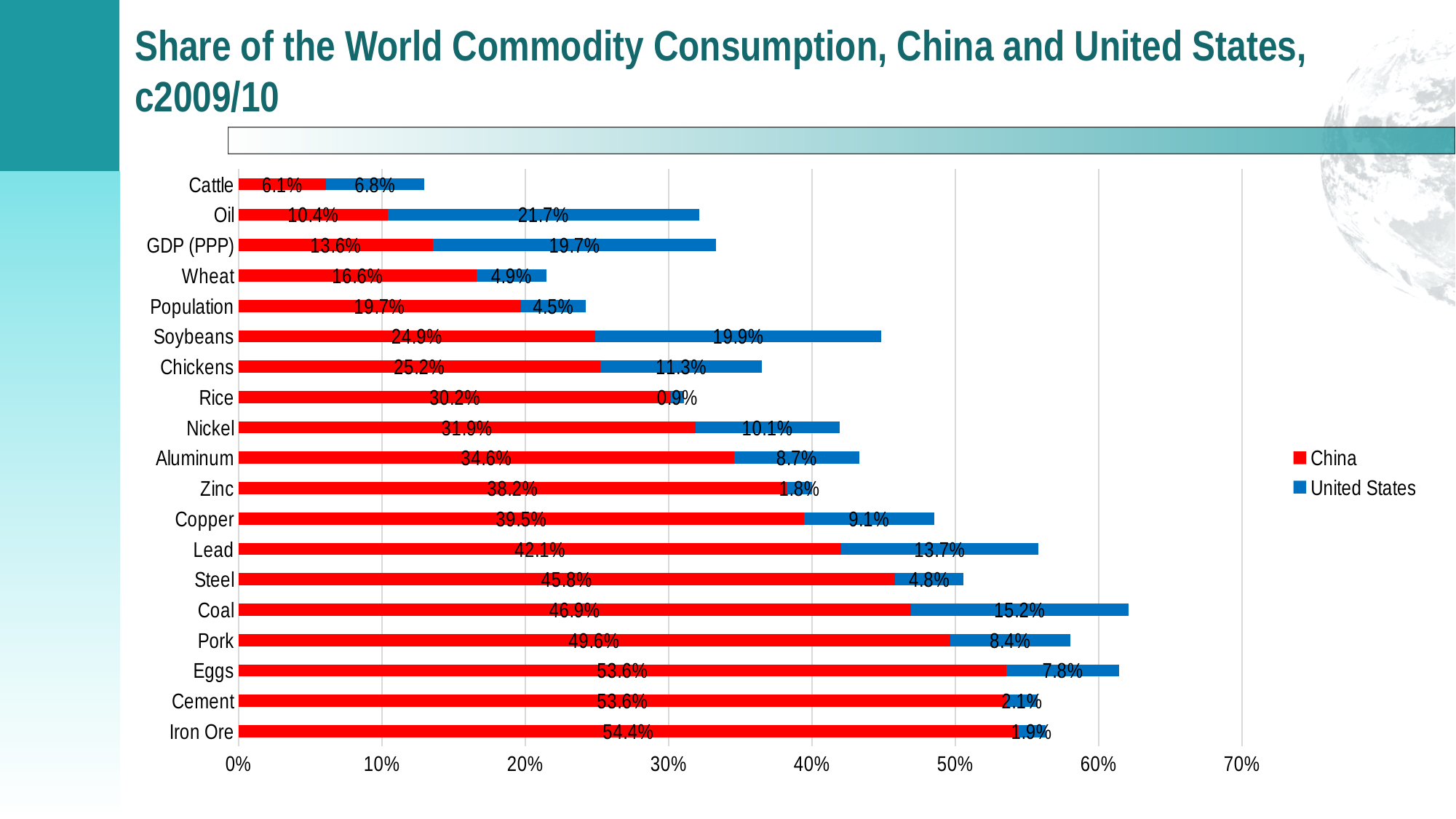
For Oil, which is larger: China's share or the United States' share? United States Which colour represents China in the chart? Red What is the difference between China's and the United States' shares for Coal? 31.7 percentage points What is the United States' share of world oil consumption? 21.7% Which category has the lowest value for the United States? Rice What kind of chart is shown on the slide? Stacked bar chart Which category has the highest value for China? Iron Ore How many series does the legend list? 2 What is the combined share of China and the United States for Iron Ore? 56.3% How many categories are shown on the chart? 19 Which category has the highest value for the United States? Oil What is China's share of world coal consumption? 46.9%